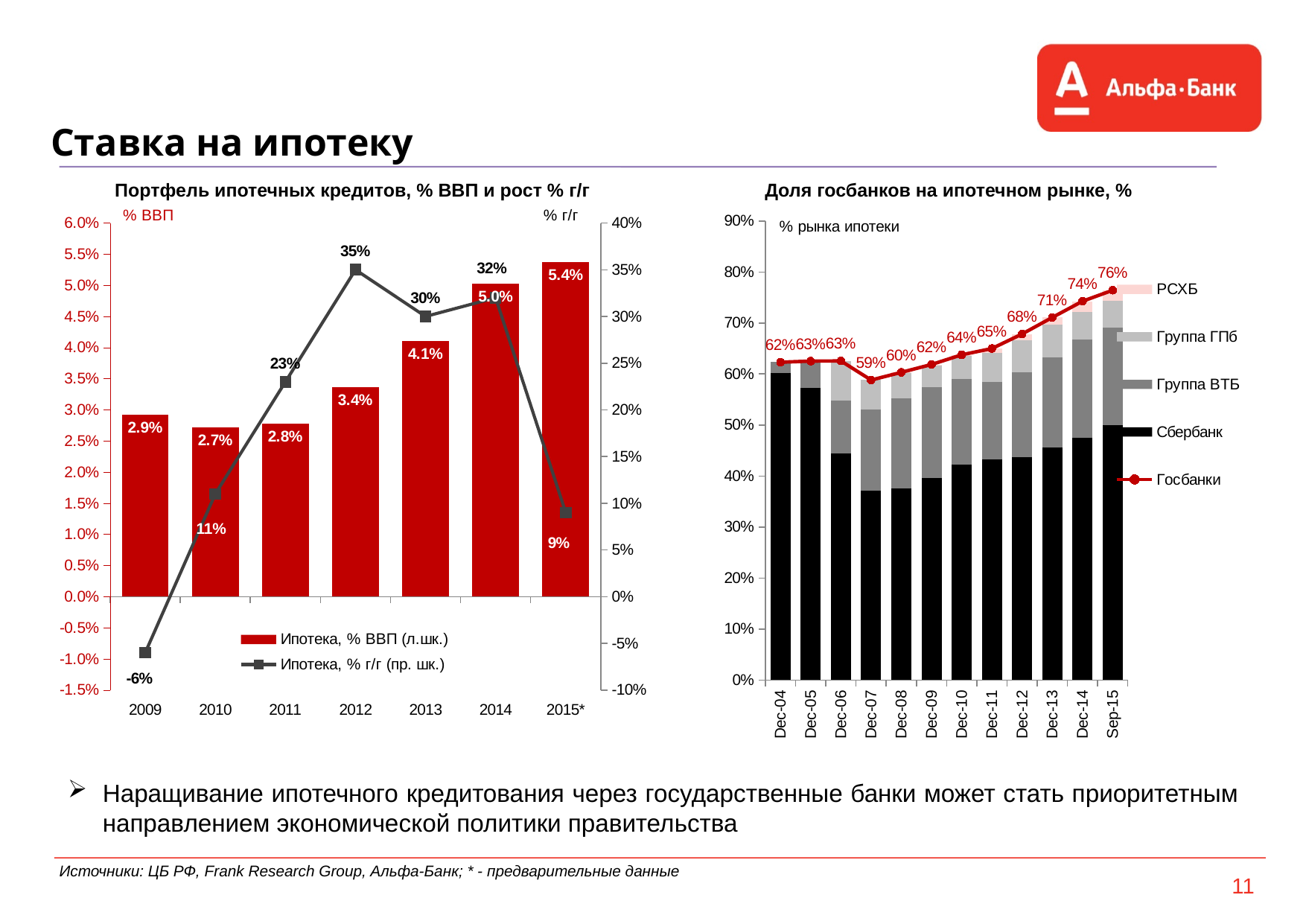
In the chart 'Доля госбанков на ипотечном рынке, %', which period has the lowest 'Госбанки' value? Dec-07 In the chart 'Портфель ипотечных кредитов, % ВВП и рост % г/г', how many series does the legend list? 2 In the chart 'Портфель ипотечных кредитов, % ВВП и рост % г/г', which is larger: the 'Ипотека, % г/г' value for 2013 or for 2014? 2014 In the chart 'Портфель ипотечных кредитов, % ВВП и рост % г/г', which year has the highest 'Ипотека, % ВВП' value? 2015* In the chart 'Портфель ипотечных кредитов, % ВВП и рост % г/г', what is the value of 'Ипотека, % ВВП' for 2013? 4.1% In the chart 'Портфель ипотечных кредитов, % ВВП и рост % г/г', what is the value of 'Ипотека, % г/г' for 2012? 35% In the chart 'Доля госбанков на ипотечном рынке, %', how many periods are shown on the x axis? 12 In the chart 'Портфель ипотечных кредитов, % ВВП и рост % г/г', which year has the lowest 'Ипотека, % г/г' value? 2009 In the chart 'Доля госбанков на ипотечном рынке, %', what is the 'Госбанки' value for Dec-13? 71% In the chart 'Доля госбанков на ипотечном рынке, %', does the 'Госбанки' line rise or fall from Dec-07 to Sep-15? rise In the chart 'Доля госбанков на ипотечном рынке, %', is the 'Сбербанк' value for Dec-07 greater or less than 40%? less In the chart 'Портфель ипотечных кредитов, % ВВП и рост % г/г', what is the difference between the 'Ипотека, % ВВП' values for 2014 and 2012? 1.6%